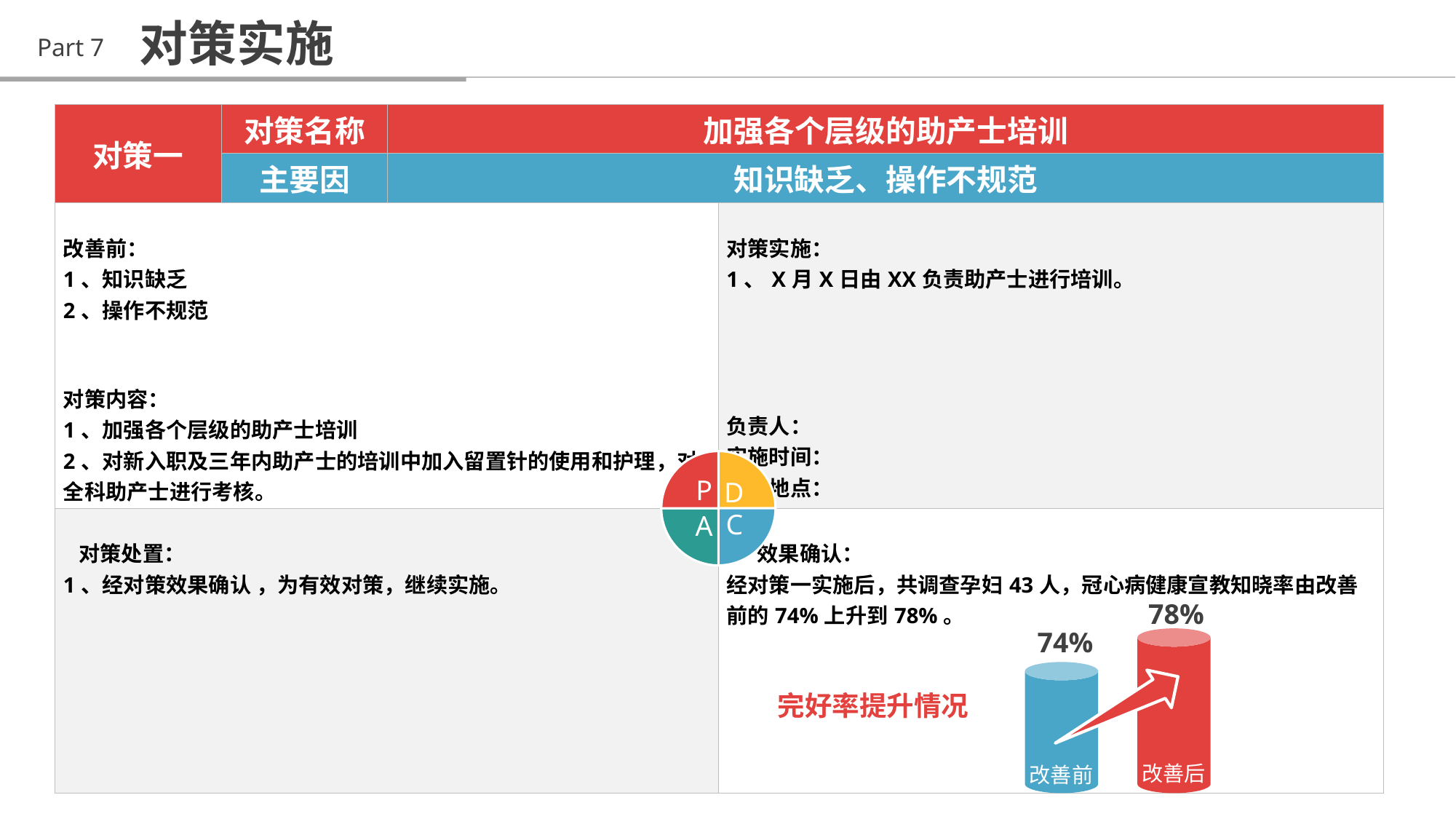
Which category has the higher value in the chart? 改善后 What is the value for 改善后 in the chart? 78% What is the title of the chart? 完好率提升情况 How many categories are shown in the chart? 2 What kind of chart is shown on the slide? bar chart What is the value for 改善前 in the chart? 74% What colour is the bar for 改善后? red Is the value for 改善前 larger or smaller than the value for 改善后? smaller Which category has the lower value in the chart? 改善前 What is the difference between the values for 改善后 and 改善前? 4% Do the values rise or fall from 改善前 to 改善后? rise